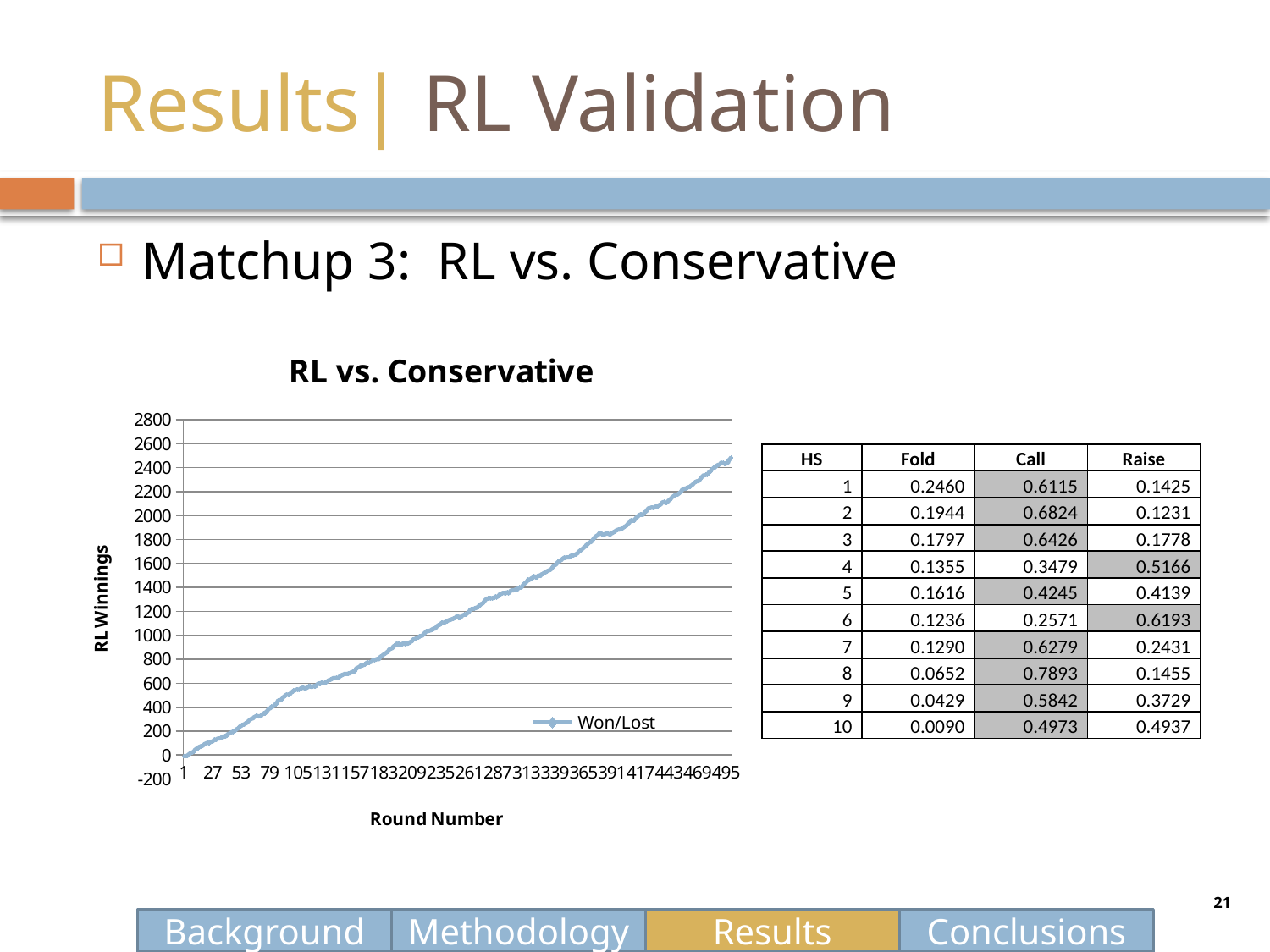
Which is larger, the RL Winnings value at round 157 or at round 339? round 339 Is the RL Winnings value at round 495 greater or less than 2200? greater Is the RL Winnings value at round 105 greater or less than 800? less How many series does the legend of the RL vs. Conservative chart list? 1 Do the RL Winnings values rise or fall as the Round Number increases? rise What kind of chart is shown on the slide? line chart What is the name of the series shown in the legend of the RL vs. Conservative chart? Won/Lost At which round number is the Won/Lost line at its lowest value? 1 What is the title of the chart on the slide? RL vs. Conservative Is the RL Winnings value at round 391 greater or less than 1400? greater